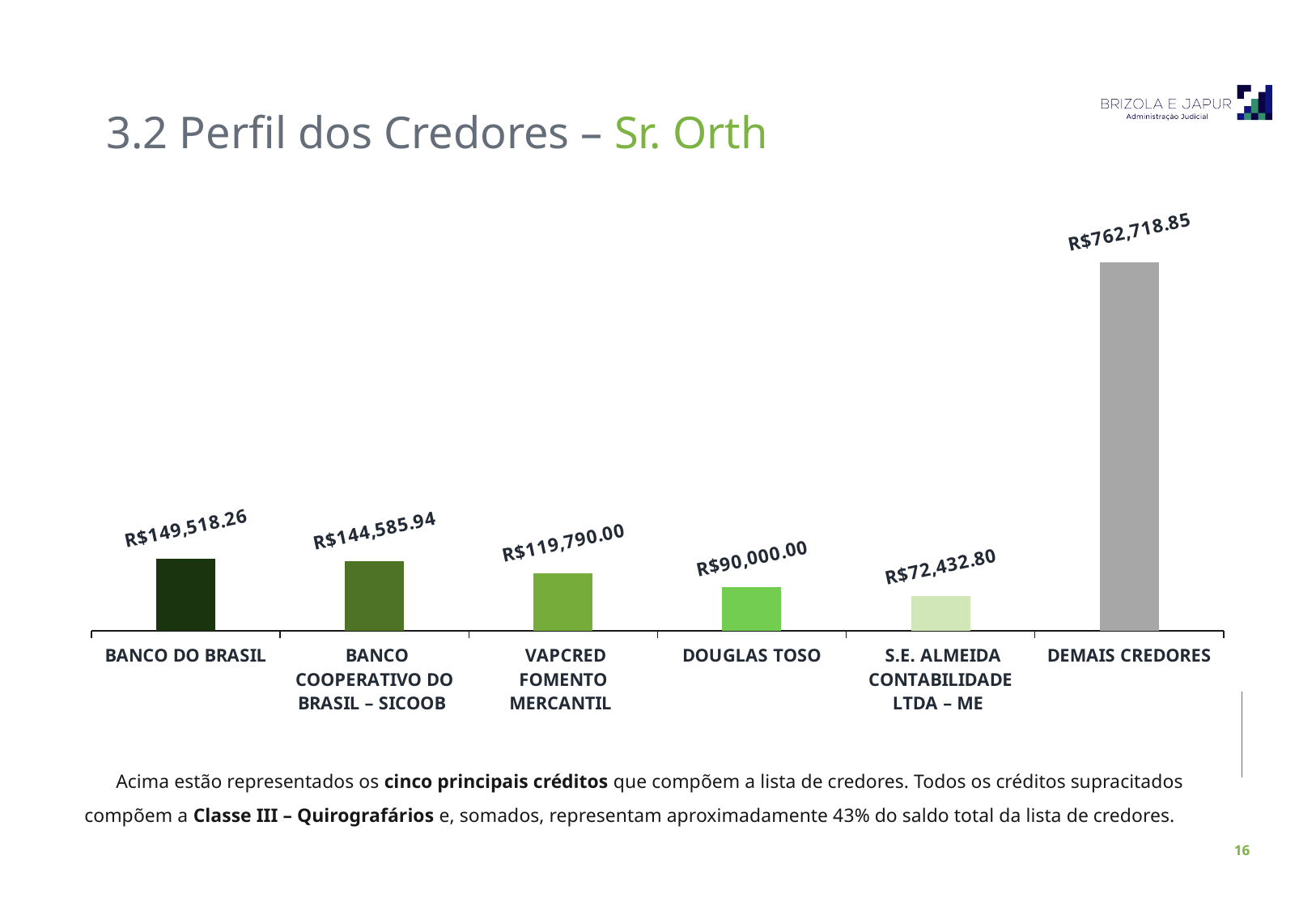
Which category has the lowest value? S.E. ALMEIDA CONTABILIDADE LTDA – ME What kind of chart is shown on the slide? Bar chart Which is larger, the value for BANCO DO BRASIL or the value for BANCO COOPERATIVO DO BRASIL – SICOOB? BANCO DO BRASIL Which category has the highest value? DEMAIS CREDORES How many categories are shown in the chart? 6 What is the value for DOUGLAS TOSO? R$90,000.00 What is the difference between the values for VAPCRED FOMENTO MERCANTIL and DOUGLAS TOSO? R$29,790.00 What is the value for BANCO DO BRASIL? R$149,518.26 What colour is the bar for DEMAIS CREDORES? Grey What is the value for S.E. ALMEIDA CONTABILIDADE LTDA – ME? R$72,432.80 What is the value for VAPCRED FOMENTO MERCANTIL? R$119,790.00 What is the difference between the values for BANCO DO BRASIL and BANCO COOPERATIVO DO BRASIL – SICOOB? R$4,932.32